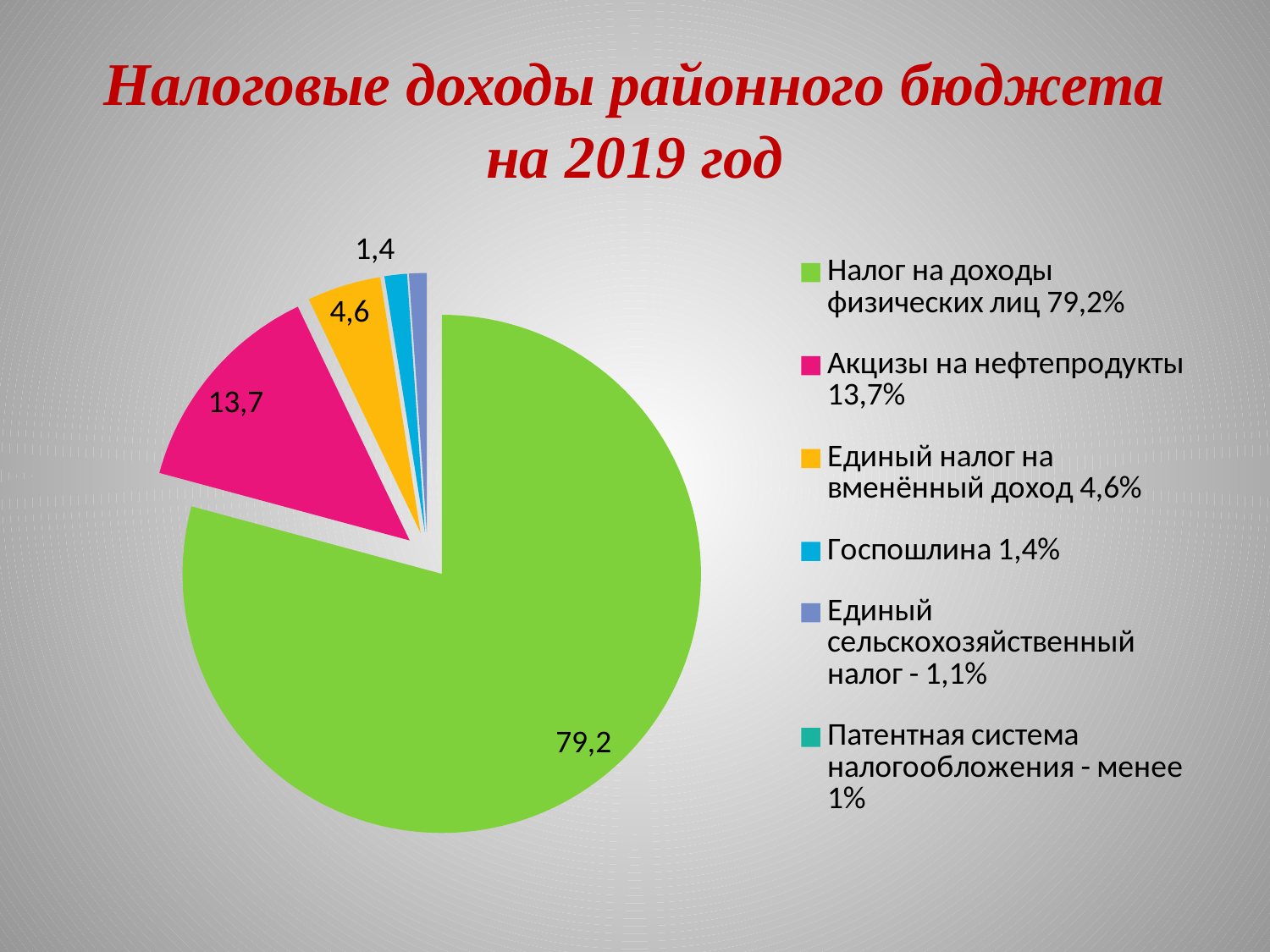
What is the title of the chart on the slide? Налоговые доходы районного бюджета на 2019 год What value is labelled on the largest slice of the pie chart? 79,2 How many categories does the legend of the pie chart list? 6 What is the difference between the labelled values for Акцизы на нефтепродукты and Единый налог на вменённый доход? 9,1 What is the difference between the labelled values for Налог на доходы физических лиц and Акцизы на нефтепродукты? 65,5 What value is labelled on the slice for Акцизы на нефтепродукты? 13,7 What value is labelled on the slice for Госпошлина? 1,4 Which category has the largest slice of the pie chart? Налог на доходы физических лиц According to the legend, what share does Единый сельскохозяйственный налог have? 1,1% What type of chart is shown on the slide? pie chart What value is labelled on the slice for Единый налог на вменённый доход? 4,6 Which is larger: the slice for Акцизы на нефтепродукты or the slice for Единый налог на вменённый доход? Акцизы на нефтепродукты